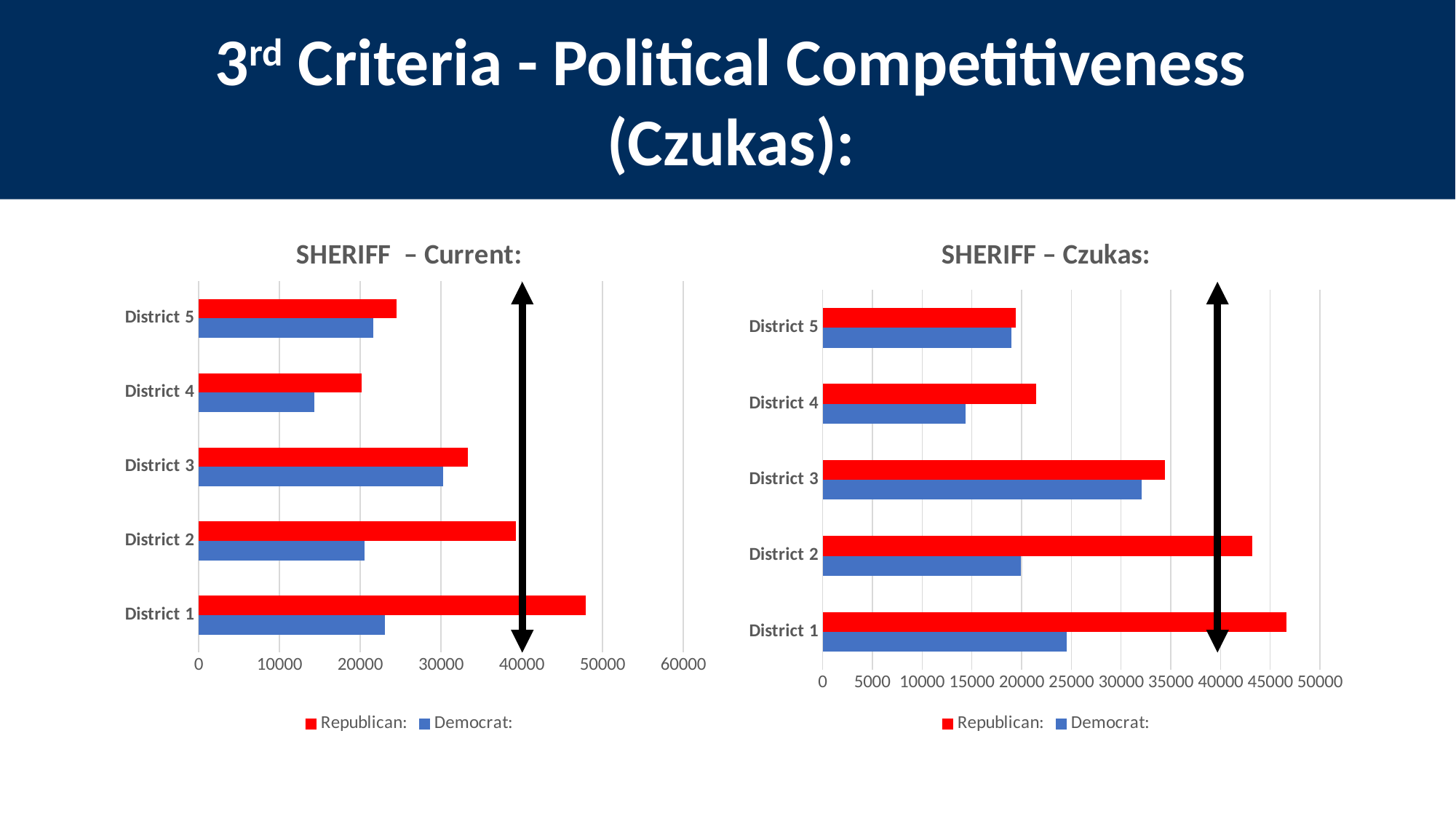
In the SHERIFF – Current chart, is the Republican value for District 1 greater or less than 40000? greater In the SHERIFF – Current chart, is the Democrat value for District 4 greater or less than 20000? less In the SHERIFF – Czukas chart, is the Republican value for District 2 greater or less than 40000? greater In the SHERIFF – Czukas chart, which district has the highest Democrat value? District 3 In the SHERIFF – Czukas chart, how many districts are plotted? 5 In the SHERIFF – Czukas chart, which district has the lowest Republican value? District 5 In the SHERIFF – Current chart, how many series does the legend list? 2 In the SHERIFF – Current chart, which district has the lowest Democrat value? District 4 In the SHERIFF – Current chart, what kind of chart is shown? bar chart In the SHERIFF – Current chart, which district has the highest Republican value? District 1 In the SHERIFF – Czukas chart, what are the two legend entries? Republican and Democrat In the SHERIFF – Czukas chart, which is larger for District 3, the Republican value or the Democrat value? Republican